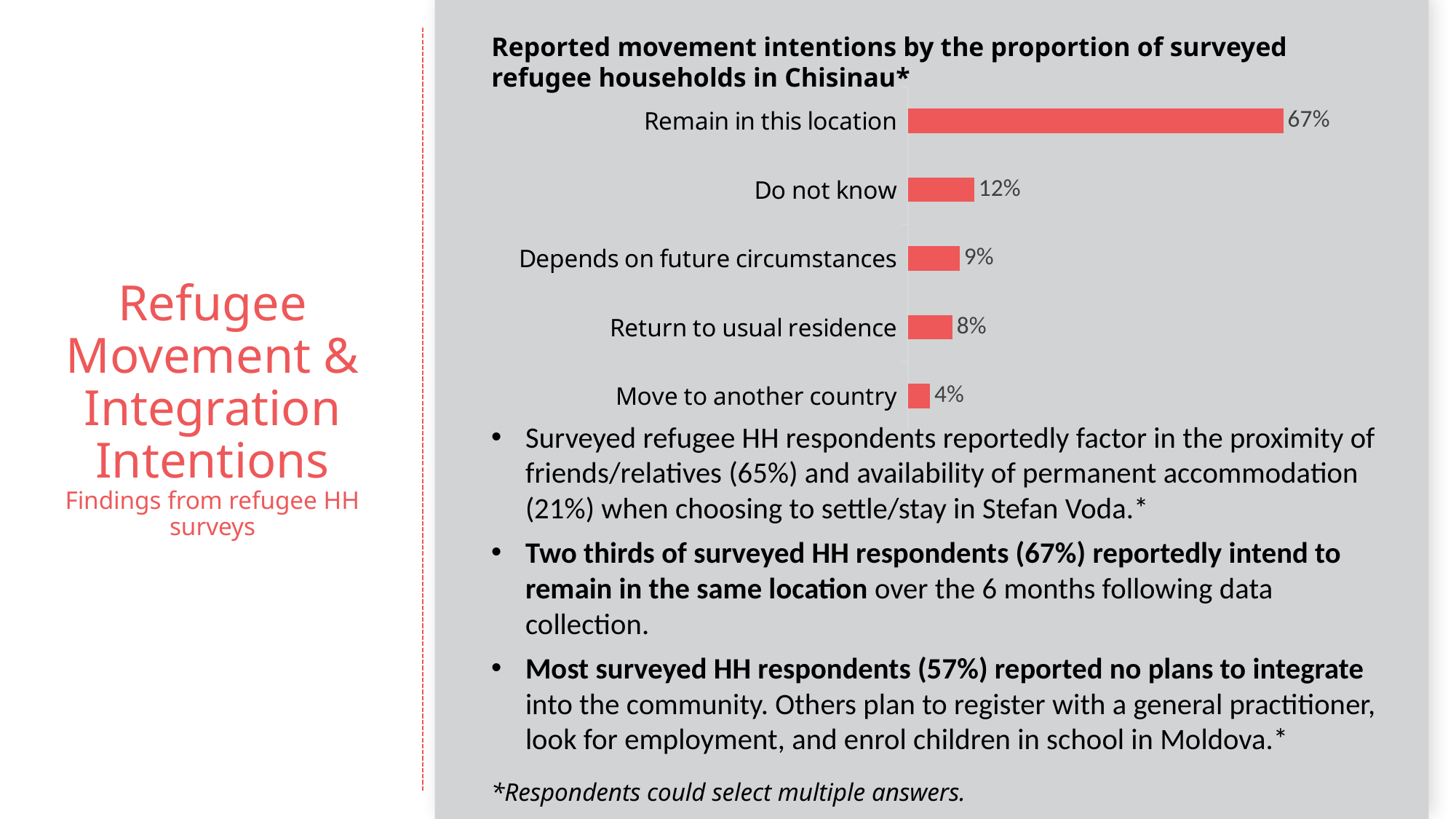
Which is larger: the value for 'Return to usual residence' or the value for 'Move to another country'? Return to usual residence Which movement intention has the highest proportion of surveyed households? Remain in this location What proportion of households said their movement intention depends on future circumstances? 9% What is the title of the chart on the slide? Reported movement intentions by the proportion of surveyed refugee households in Chisinau* How many movement intention categories are shown in the chart? 5 What is the value for 'Do not know' in the chart? 12% What is the value for 'Return to usual residence'? 8% What percentage of households intend to move to another country? 4% What is the difference in percentage points between 'Remain in this location' and 'Do not know'? 55 What type of chart is used to show the reported movement intentions? Bar chart What percentage of surveyed refugee households reported intending to remain in this location? 67% Which movement intention has the lowest proportion of surveyed households? Move to another country